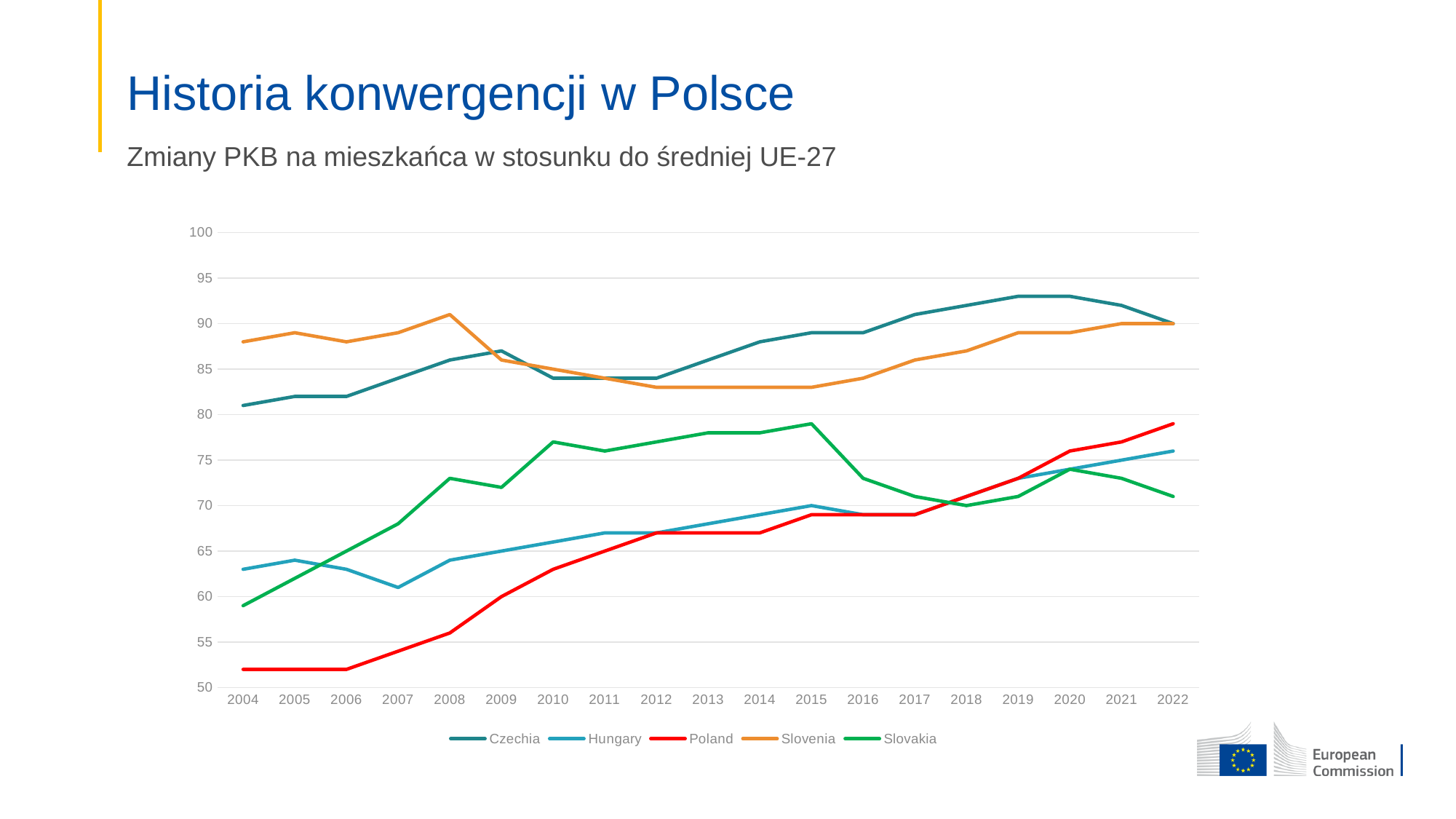
Is the value for Slovenia in 2008 greater or less than 90? greater How many years are shown on the x axis? 19 Which country has the lowest value in 2022? Slovakia In 2022, which is higher: Poland or Hungary? Poland How many series does the legend list? 5 Which country has the highest value in 2019? Czechia What is the value for Czechia in 2022? 90 Is the value for Poland in 2004 greater or less than 55? less What kind of chart is shown on the slide? line chart What is the value for Hungary in 2015? 70 Does the Poland line generally rise or fall from 2004 to 2022? rise Which country has the lowest value in 2004? Poland